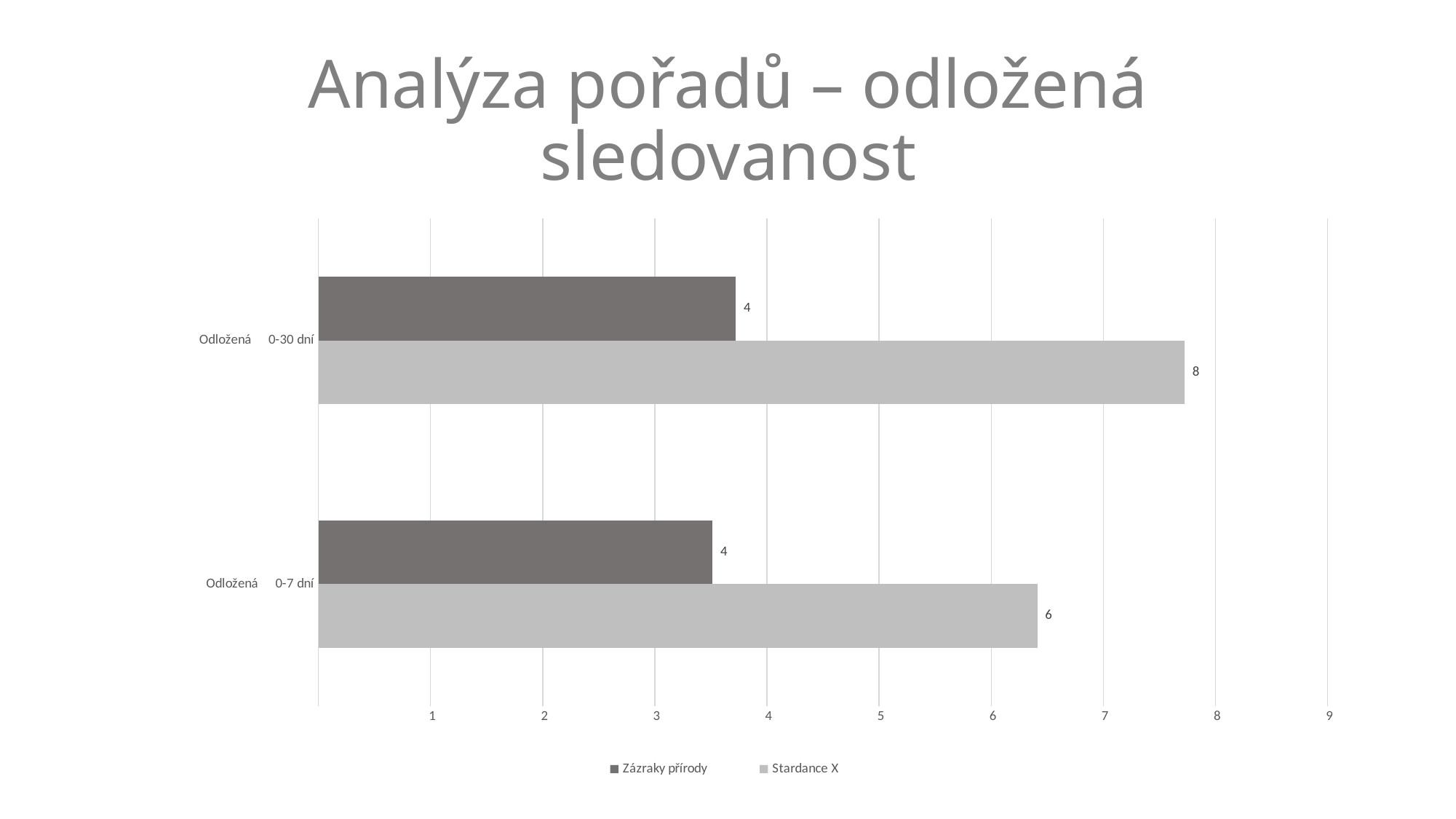
Which series has the higher value in the Odložená 0-30 dní category? Stardance X How many categories are shown on the chart? 2 What is the difference between Stardance X and Zázraky přírody in the Odložená 0-30 dní category? 4 What is the value for Stardance X in the Odložená 0-30 dní category? 8 What is the value for Zázraky přírody in the Odložená 0-7 dní category? 4 Is the value for Stardance X in the Odložená 0-30 dní category greater or less than 7? greater Which category has the highest value for Stardance X? Odložená 0-30 dní What is the value for Stardance X in the Odložená 0-7 dní category? 6 How many series does the legend list? 2 What kind of chart is shown on the slide? Bar chart What is the difference between Stardance X and Zázraky přírody in the Odložená 0-7 dní category? 2